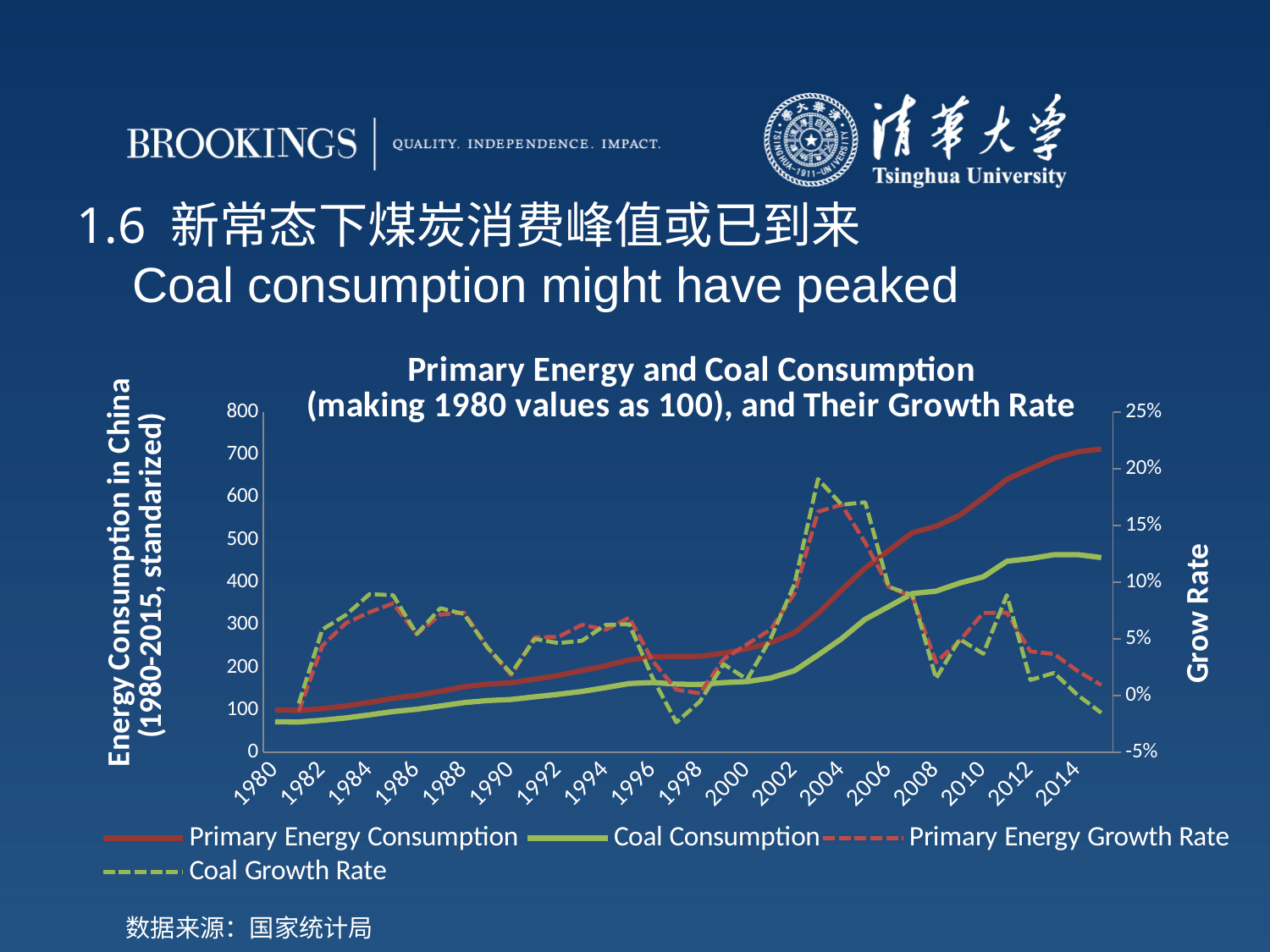
Is the value for Coal Consumption in 2014 greater or less than 500? less Does Primary Energy Consumption rise or fall from 1980 to 2014? rise How many series does the legend list? 4 What kind of chart is shown on the slide? line chart What is the label of the right-hand vertical axis? Grow Rate What is the value of Primary Energy Consumption in 1980? 100 What is the title of the chart? Primary Energy and Coal Consumption (making 1980 values as 100), and Their Growth Rate Is the Coal Growth Rate in 2003 greater or less than 15%? greater Is the Primary Energy Growth Rate in 1998 greater or less than 5%? less In 2014, which is higher: Primary Energy Consumption or Coal Consumption? Primary Energy Consumption